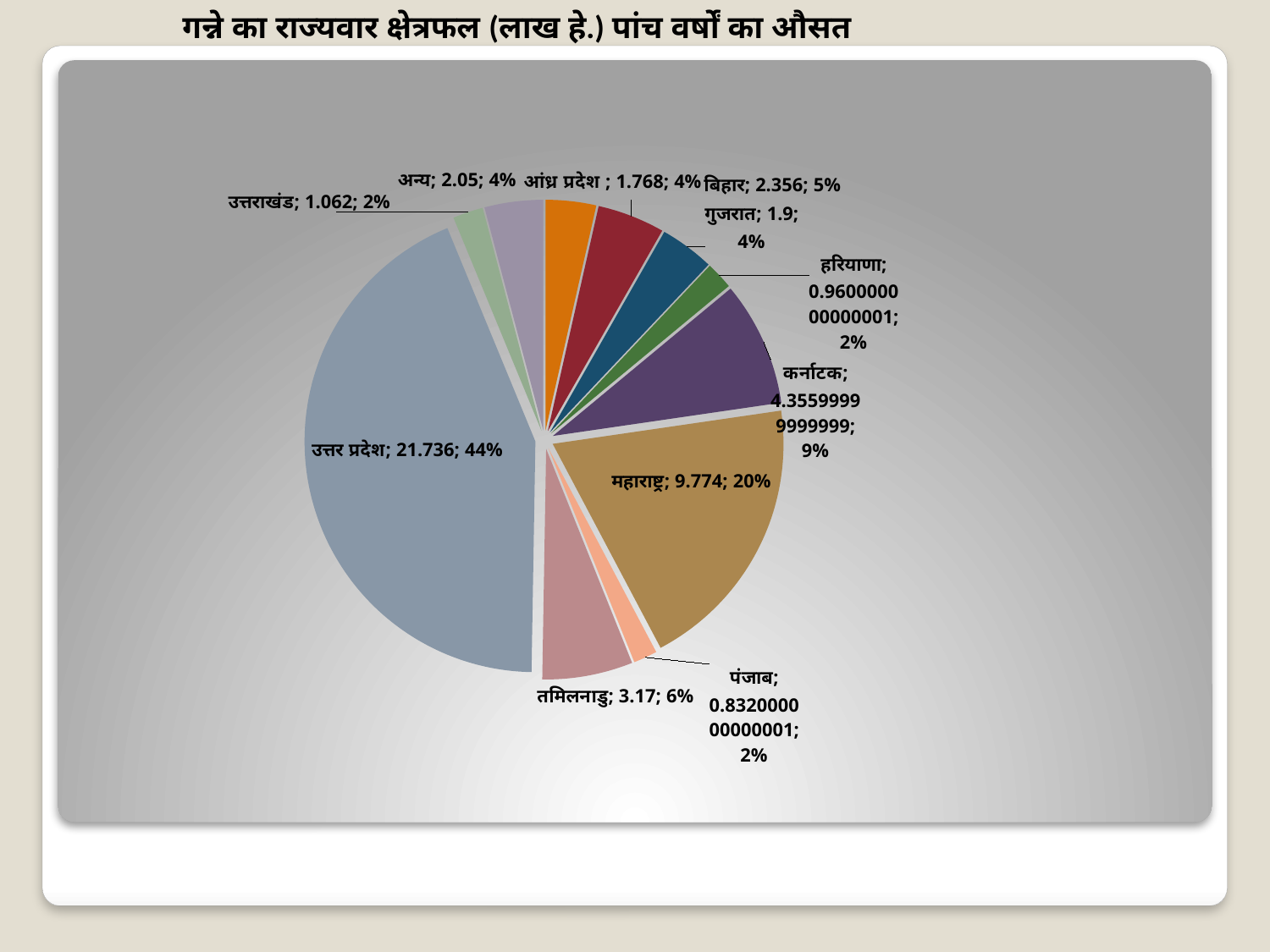
What kind of chart is shown on the slide? pie chart What is the difference between the values for उत्तर प्रदेश and महाराष्ट्र? 11.962 What is the value shown for बिहार? 2.356 How many slices does the pie chart have? 11 What is the value shown for तमिलनाडु? 3.17 What percentage share of the pie does उत्तर प्रदेश have? 44% What is the value shown for महाराष्ट्र? 9.774 What percentage share of the pie does कर्नाटक have? 9% Which state has the largest slice of the pie? उत्तर प्रदेश What is the value shown for उत्तर प्रदेश? 21.736 What is the title of the slide? गन्ने का राज्यवार क्षेत्रफल (लाख हे.) पांच वर्षों का औसत Which of the two has a larger value, महाराष्ट्र or तमिलनाडु? महाराष्ट्र